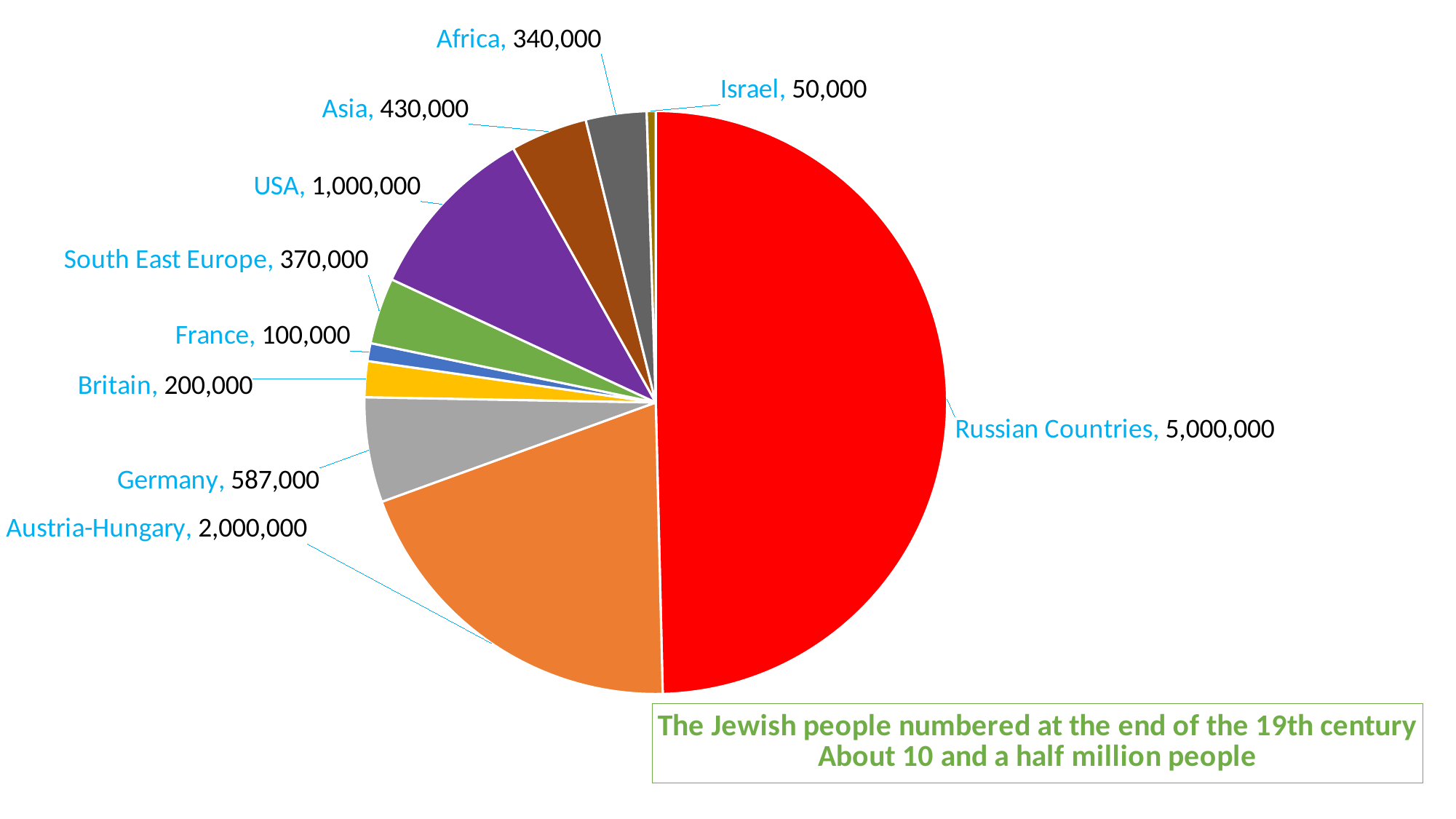
How many categories are shown in the pie chart? 10 What is the value for South East Europe? 370,000 What is the value for Germany? 587,000 Which is larger, the value for USA or the value for Germany? USA Which category has the largest slice? Russian Countries What kind of chart is shown on the slide? Pie chart What colour is the slice for Austria-Hungary? Orange What is the difference between the values for Russian Countries and Austria-Hungary? 3,000,000 What is the value for Russian Countries? 5,000,000 Which category has the smallest slice? Israel What is the difference between the values for Asia and Africa? 90,000 What is the value for Israel? 50,000